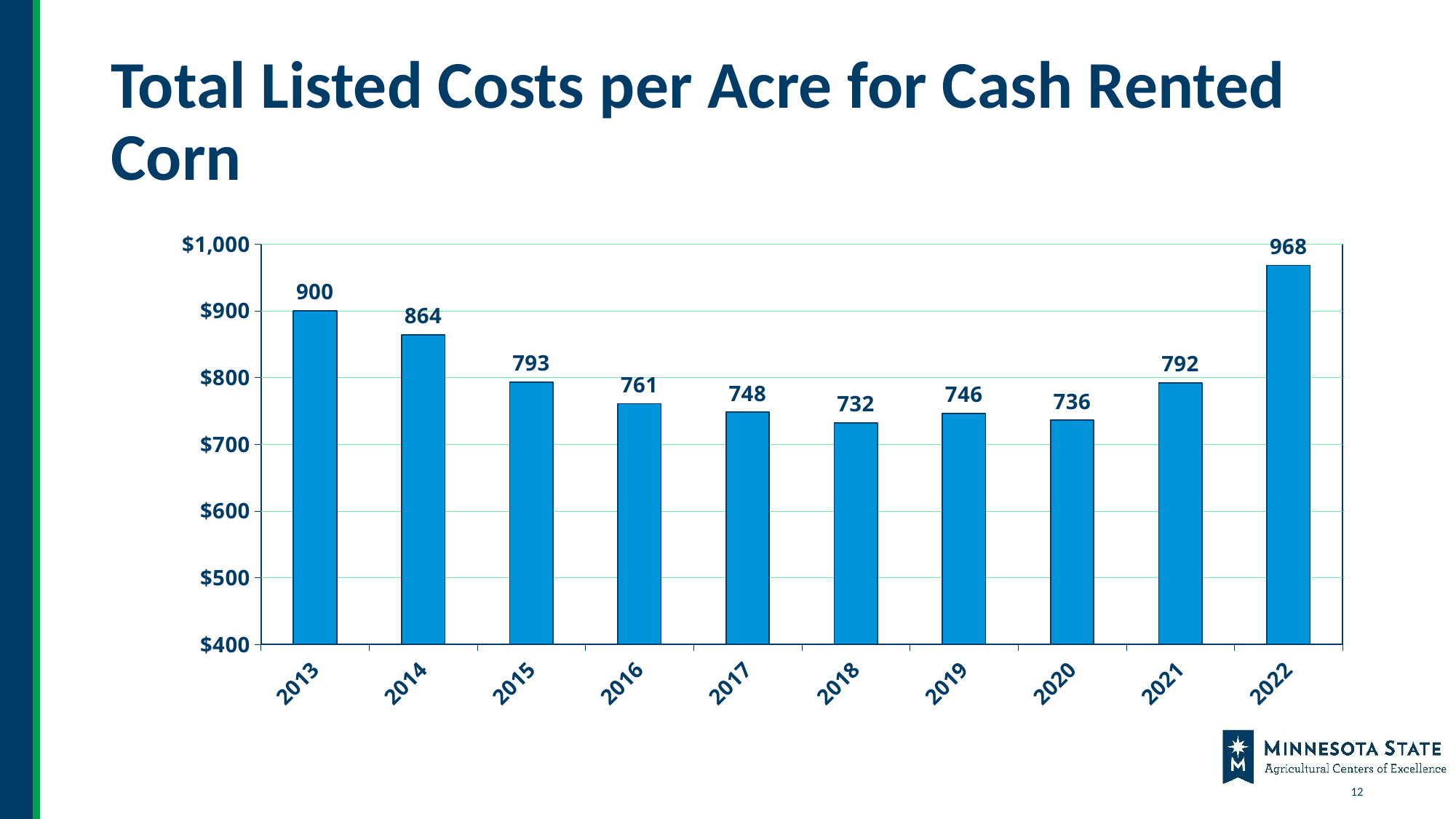
Which year has the highest total listed cost per acre? 2022 What is the total listed cost per acre for cash rented corn in 2013? 900 What is the value shown for 2018? 732 What is the difference between the 2022 value and the 2013 value? 68 How many years are shown on the x axis? 10 What is the difference between the 2014 value and the 2015 value? 71 Which is larger, the value for 2016 or the value for 2017? 2016 Do the values rise or fall from 2013 to 2015? fall What kind of chart is shown on the slide? bar chart Which year has the lowest total listed cost per acre? 2018 Is the value for 2020 greater or less than $800? less What is the value shown for 2021? 792